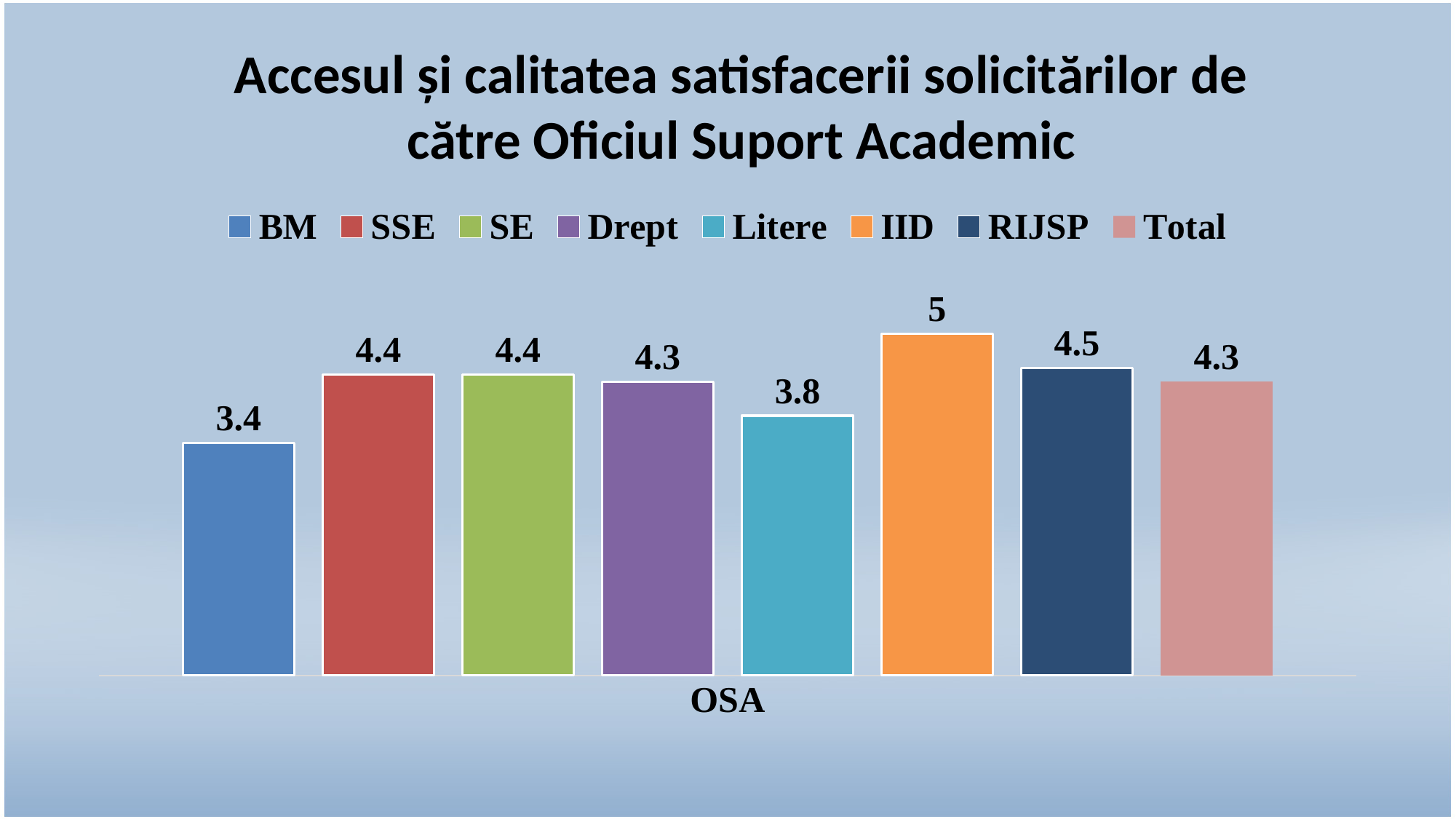
How many series does the legend list? 8 What is the value for RIJSP? 4.5 What kind of chart is shown on the slide? bar chart What is the label shown on the x axis below the bars? OSA Which is larger, the value for Drept or the value for Litere? Drept Which series has the highest value? IID Which series has the lowest value? BM What is the difference between the values for RIJSP and Litere? 0.7 What is the value for IID? 5 What is the value for Litere? 3.8 What is the value for BM? 3.4 What is the difference between the values for IID and BM? 1.6